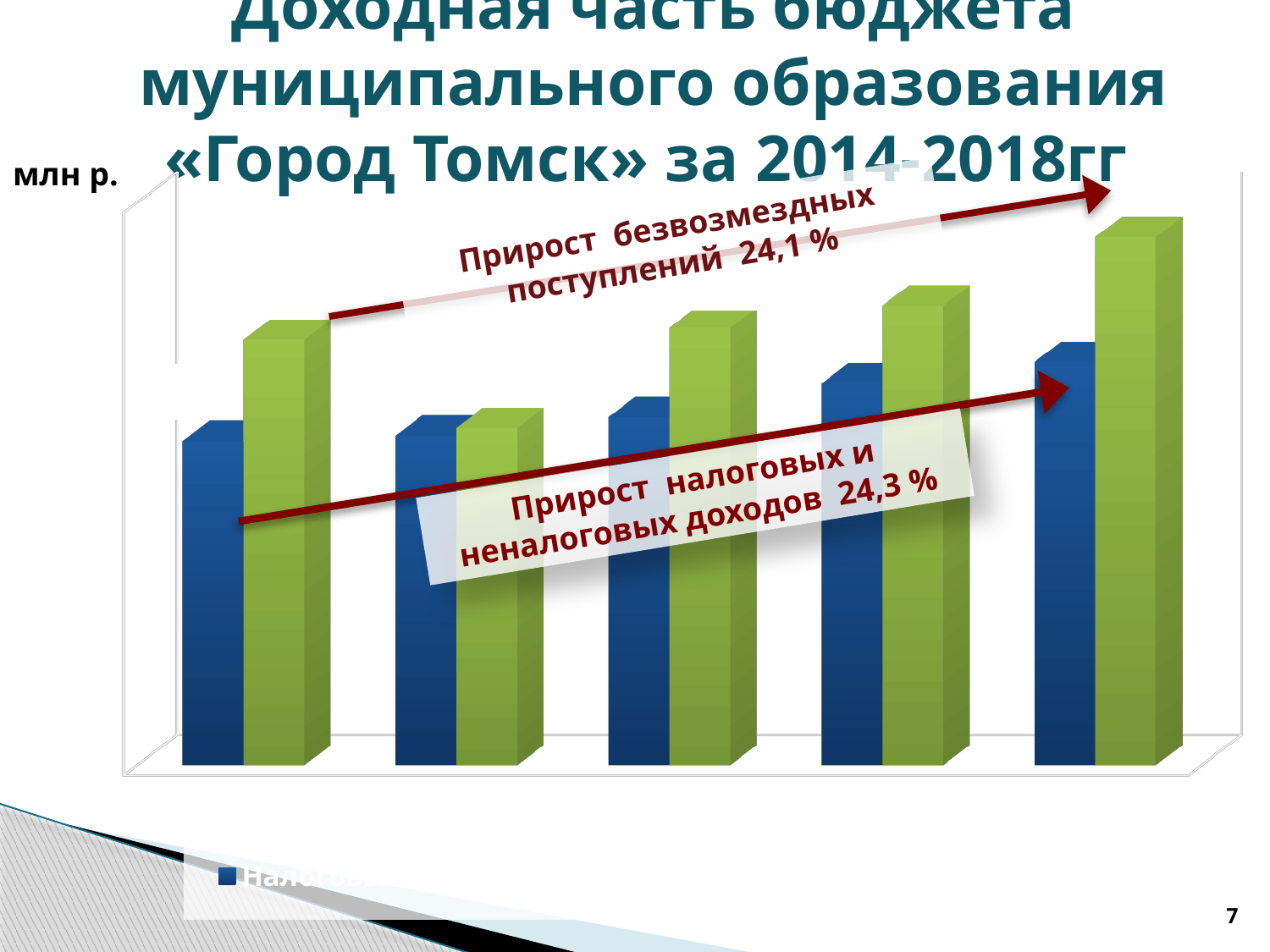
Which green bar is the tallest in the chart? the fifth (rightmost) green bar What kind of chart is shown on the slide? bar chart How many groups of bars are plotted in the chart? 5 According to the annotation on the chart, what is the growth of gratuitous receipts (безвозмездных поступлений)? 24,1 % Do the blue bars rise or fall from left to right across the chart? rise In the leftmost group of bars, which is taller: the blue bar or the green bar? the green bar In the rightmost group of bars, which is taller: the blue bar or the green bar? the green bar Which group of bars, counting from the left, contains the tallest bar in the chart? the fifth (rightmost) group How many data series (bar colours) are plotted in the chart? 2 According to the annotation on the chart, what is the growth of tax and non-tax revenues (налоговых и неналоговых доходов)? 24,3 % Which blue bar is the shortest in the chart? the first (leftmost) blue bar